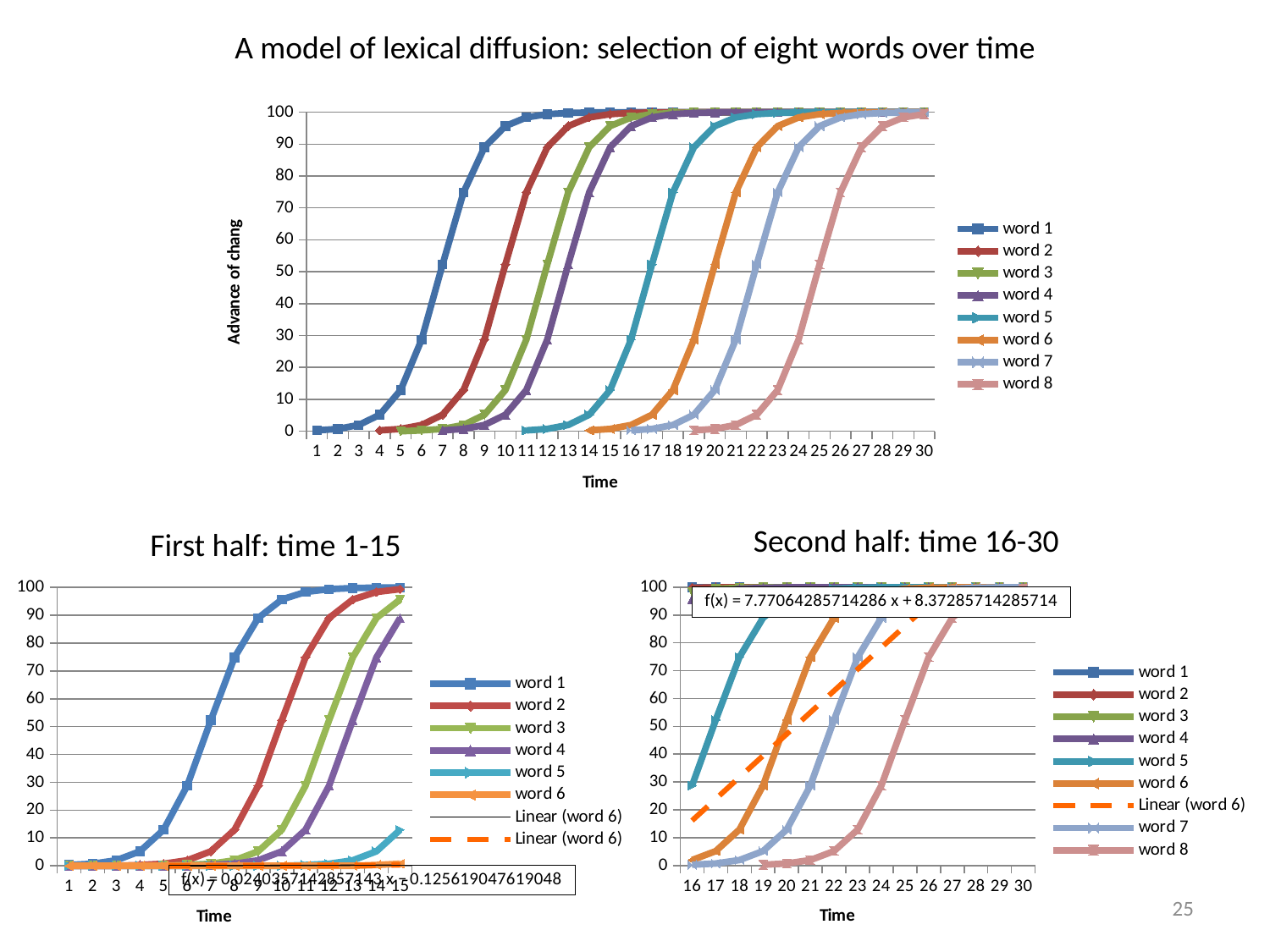
In the 'First half: time 1-15' chart, which word has the lowest value at time 15? word 6 How many entries does the legend of the 'Second half: time 16-30' chart list? 9 How many time points are shown on the x axis of the top chart? 30 What is the y-axis title of the top chart? Advance of chang In the top chart, which word reaches 100 first? word 1 In the top chart, is the value for word 1 at time 8 greater or less than 70? greater What kind of chart is the top chart titled 'A model of lexical diffusion: selection of eight words over time'? line chart How many series does the legend of the top chart list? 8 In the top chart, do the values for word 1 rise or fall as time increases? rise What is the trendline equation shown on the 'Second half: time 16-30' chart? f(x) = 7.77064285714286 x + 8.37285714285714 In the top chart, is the value for word 5 at time 16 greater or less than 40? less In the top chart, which is larger at time 10: the value for word 1 or the value for word 2? word 1